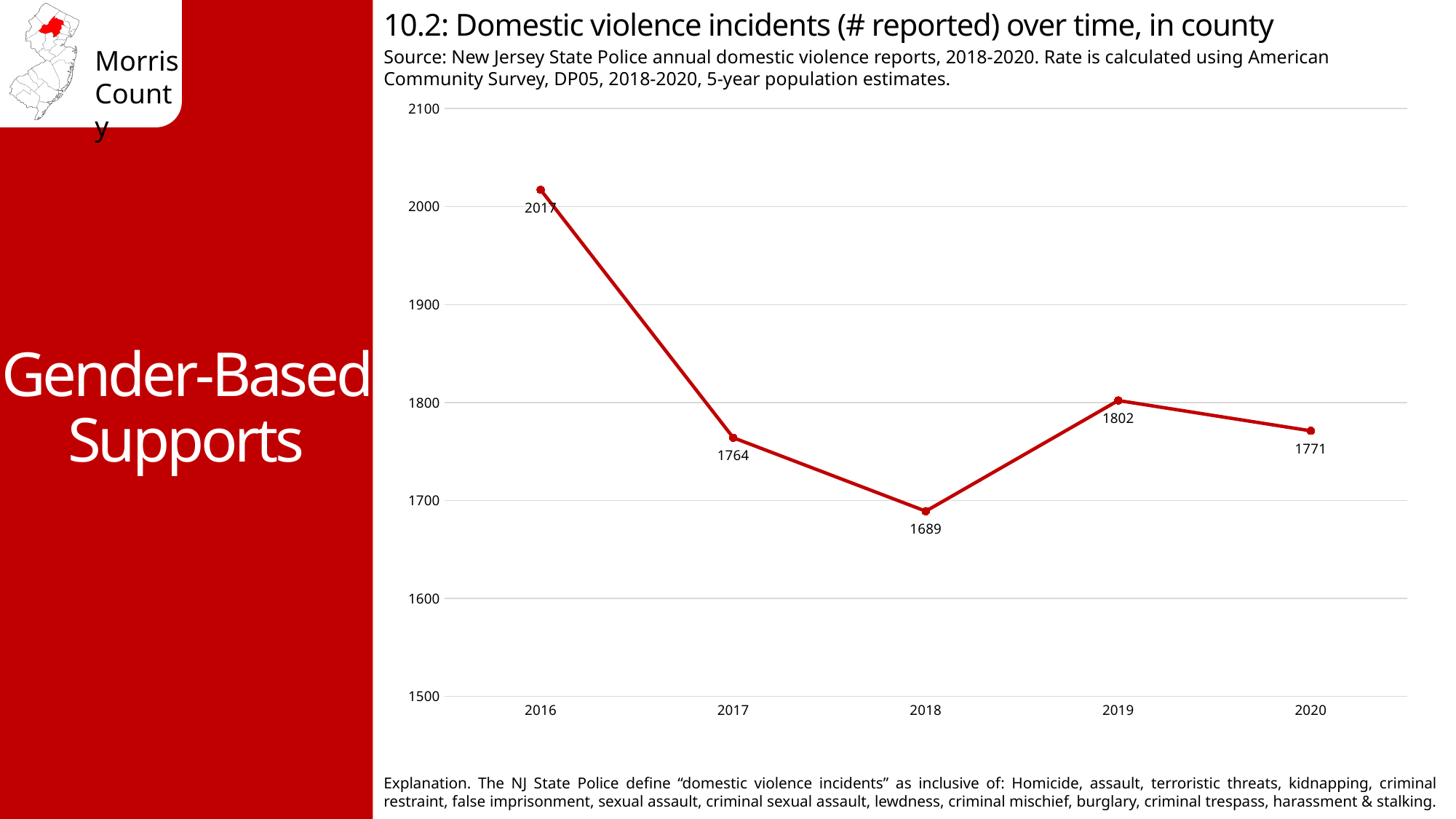
What is the difference in reported incidents between 2016 and 2018? 328 Is the value for 2017 greater or less than 1800? less What kind of chart is shown on the slide? line chart How many years are plotted on the chart? 5 Which year had the lowest number of reported domestic violence incidents? 2018 Which year had the highest number of reported domestic violence incidents? 2016 What was the number of reported domestic violence incidents in 2020? 1771 What was the number of reported domestic violence incidents in 2016? 2017 What was the number of reported domestic violence incidents in 2018? 1689 What is the difference in reported incidents between 2019 and 2020? 31 Did the number of reported incidents rise or fall from 2016 to 2018? fall Which year had more reported incidents, 2017 or 2019? 2019